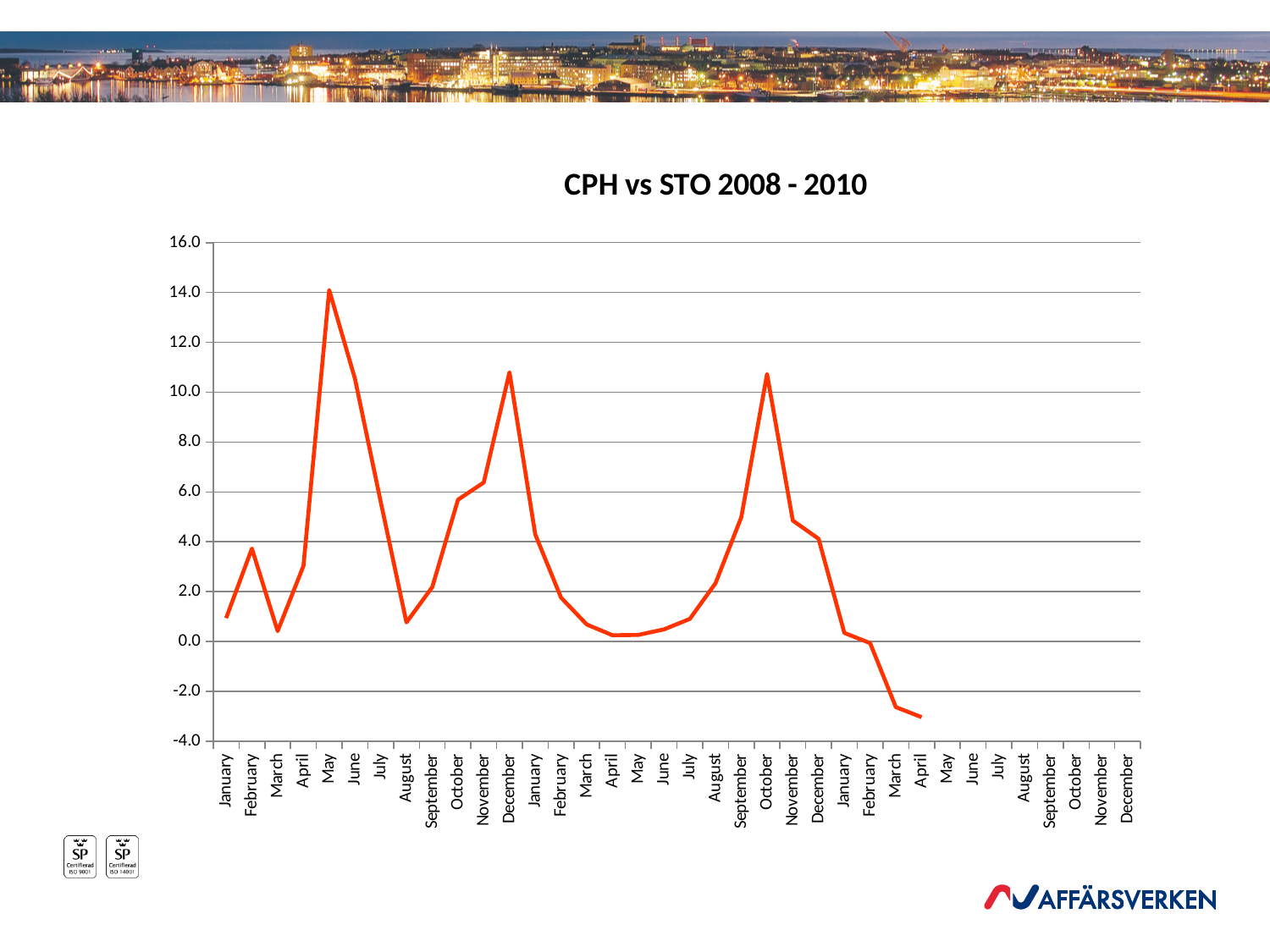
Is the value for the first December greater or less than 10.0? greater In which month does the line reach its lowest value? April (third year) In which month does the line reach its highest value? May (first year) Is the value for the third-year April greater or less than -2.0? less Is the value for the second-year April greater or less than 2.0? less Which is larger, the value for the first May or the value for the first December? first May Does the line rise or fall from the first May to the first August? fall Does the line rise or fall from the second-year April to the second-year October? rise What is the title of the chart? CPH vs STO 2008 - 2010 How many month labels are shown on the x axis? 36 What kind of chart is shown on the slide? line chart